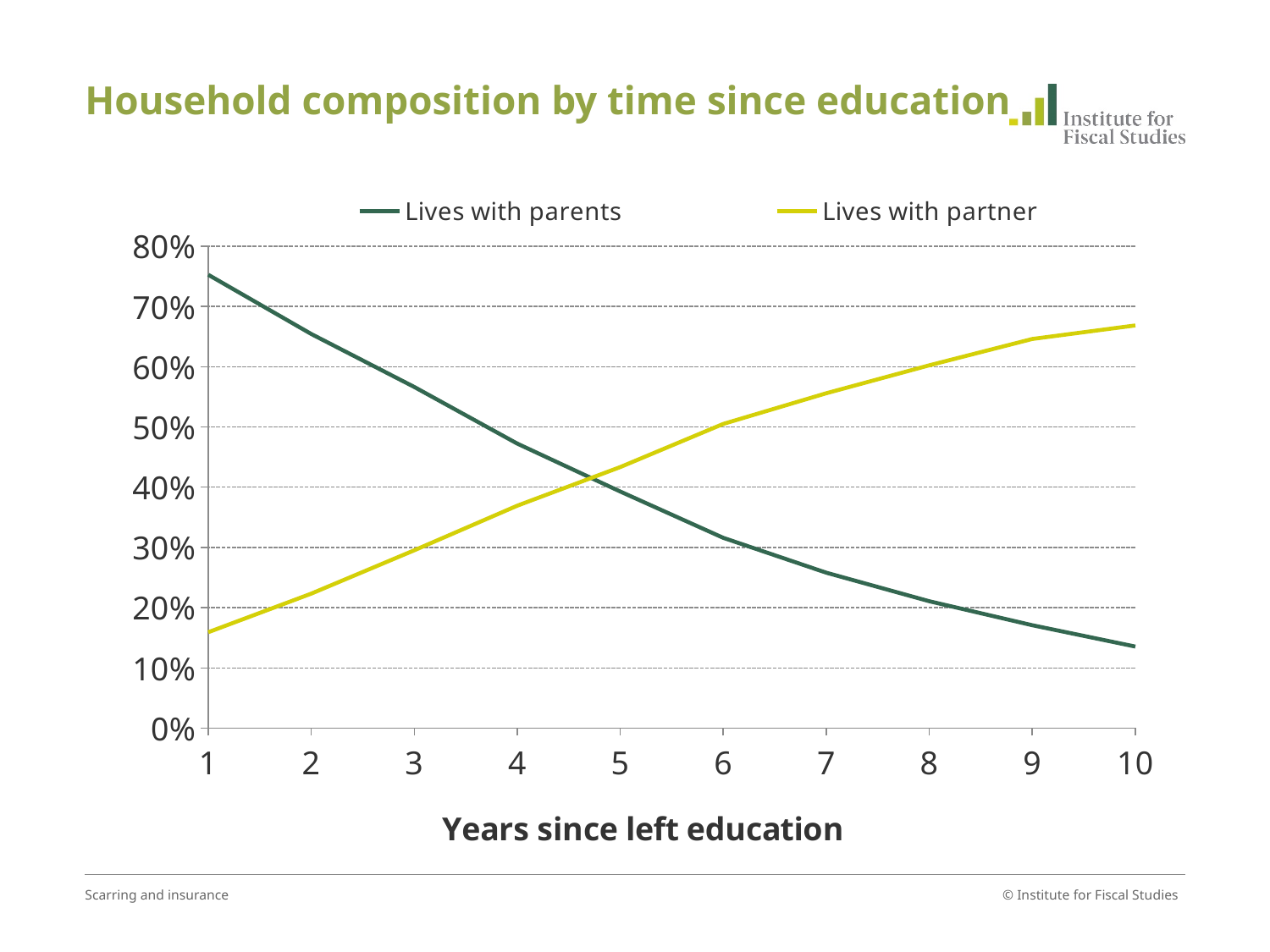
Is the value for 'Lives with parents' at year 1 greater or less than 70%? greater Does the 'Lives with partner' line rise or fall as years since left education increase? rise Is the value for 'Lives with parents' at year 10 greater or less than 20%? less What is the title of the x axis? Years since left education Does the 'Lives with parents' line rise or fall as years since left education increase? fall Is the value for 'Lives with partner' at year 1 greater or less than 20%? less At year 8, which series has the larger value: 'Lives with parents' or 'Lives with partner'? Lives with partner At year 2, which series has the larger value: 'Lives with parents' or 'Lives with partner'? Lives with parents How many series does the legend list? 2 What kind of chart is shown on the slide? line chart How many points along the x axis (years since left education) are plotted for each series? 10